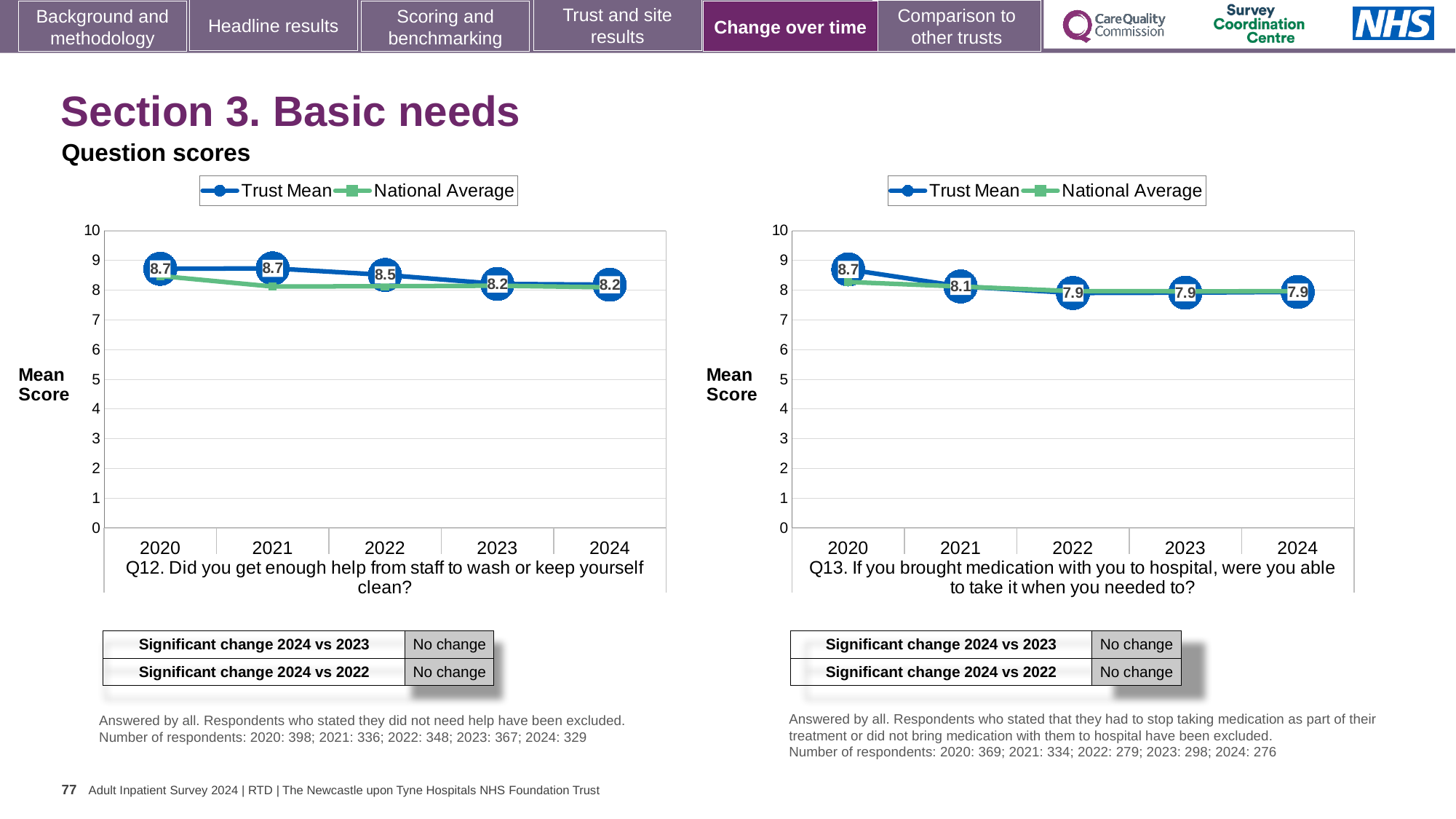
What type of chart is the Q13 chart (right)? line chart In the Q13 chart (right), which year has the highest Trust Mean? 2020 In the Q12 chart (left), what is the Trust Mean for 2022? 8.5 How many series does the legend of the Q12 chart (left) list? 2 In the Q13 chart (right), what is the difference between the Trust Mean in 2020 and in 2022? 0.8 In the Q13 chart (right), what is the Trust Mean for 2021? 8.1 In the Q12 chart (left), what is the Trust Mean for 2024? 8.2 How many years are plotted on the x axis of the Q13 chart (right)? 5 In the Q12 chart (left), what is the Trust Mean for 2020? 8.7 In the Q13 chart (right), what is the Trust Mean for 2024? 7.9 In the Q12 chart (left), what is the difference between the Trust Mean in 2020 and in 2024? 0.5 In the Q12 chart (left), does the Trust Mean rise or fall from 2020 to 2024? fall